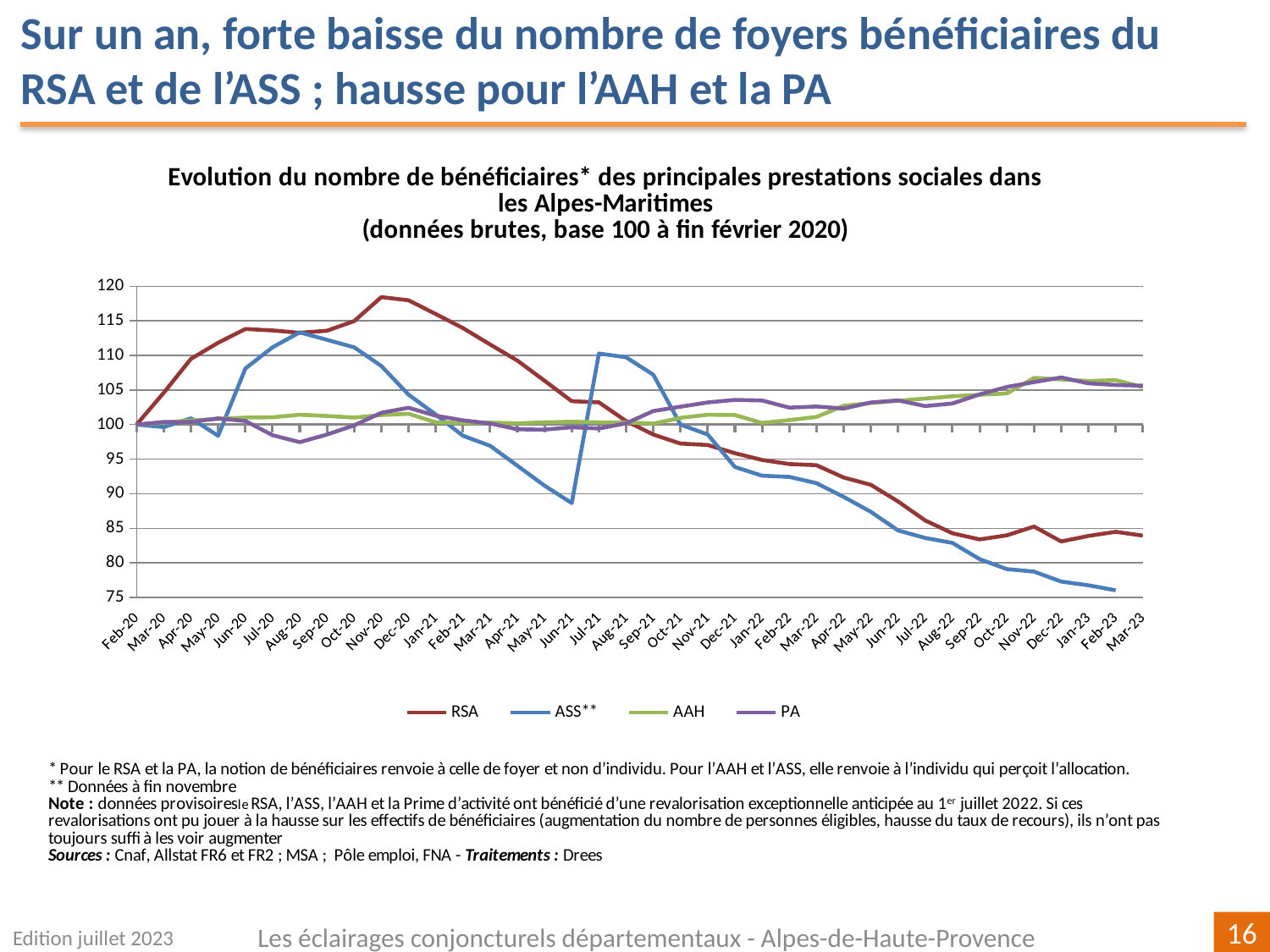
What kind of chart is shown on the slide? line chart Is the value for AAH in Mar-23 greater or less than 100? greater How many series does the legend list? 4 Does the RSA series rise or fall between Nov-20 and Mar-23? fall What is the base period of the index (value 100) according to the chart title? fin février 2020 Is the value for RSA in Nov-20 greater or less than 115? greater Which series are listed in the legend? RSA, ASS**, AAH, PA Is the value for ASS** in Jun-21 greater or less than 90? less Which series has the lowest value in Mar-23? RSA Which series has the highest value in Nov-20? RSA